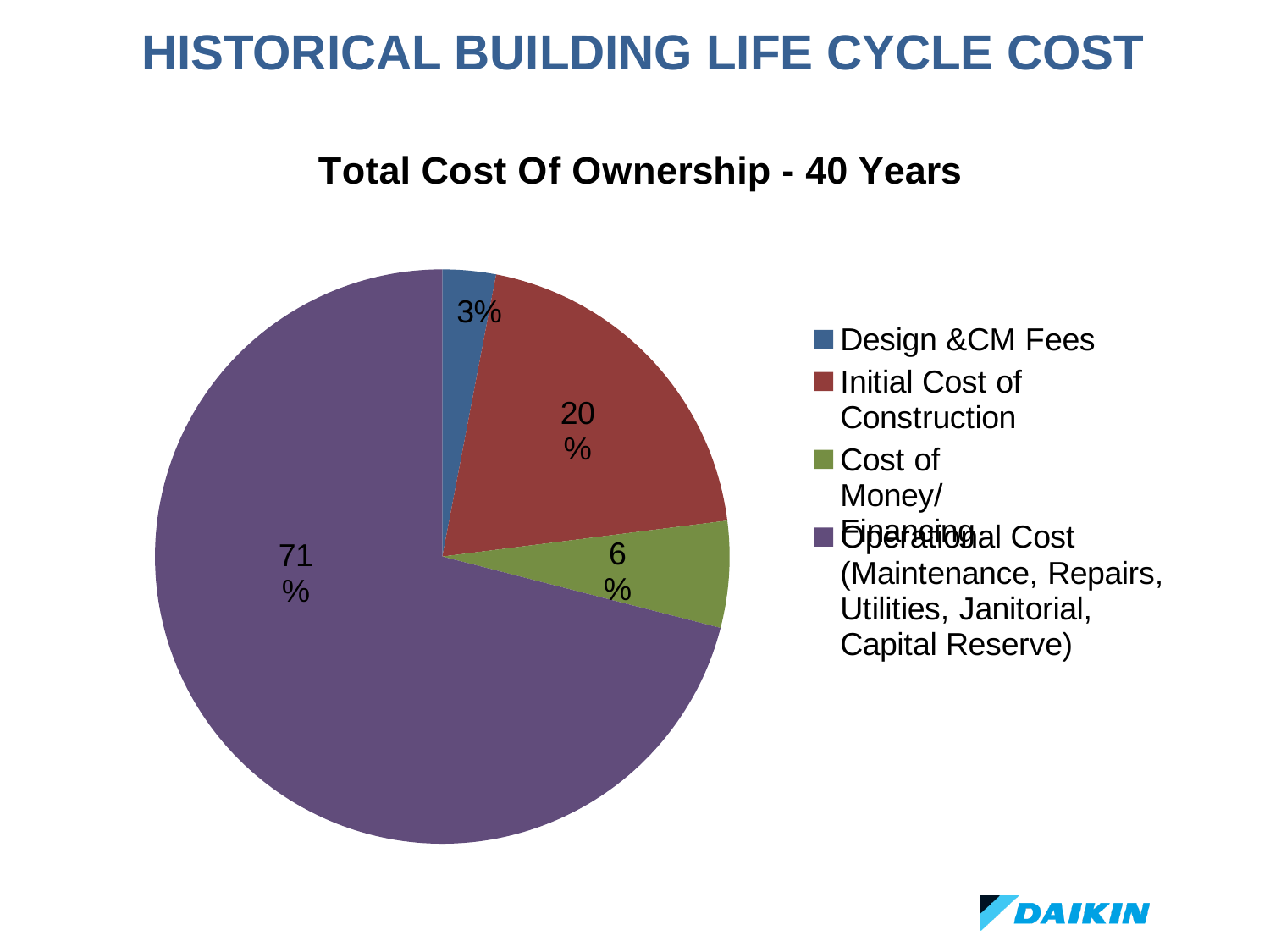
Which is larger, the share for Initial Cost of Construction or the share for Cost of Money/Financing? Initial Cost of Construction What is the difference between the Operational Cost share and the Initial Cost of Construction share? 51% What share of the pie is Initial Cost of Construction? 20% What share of the pie is Operational Cost? 71% What share of the pie is Design & CM Fees? 3% Which category has the largest share of the pie? Operational Cost How many slices does the pie chart have? 4 How many entries does the legend list? 4 What is the title of the chart? Total Cost Of Ownership - 40 Years Which category has the smallest share of the pie? Design & CM Fees What kind of chart is shown on the slide? Pie chart